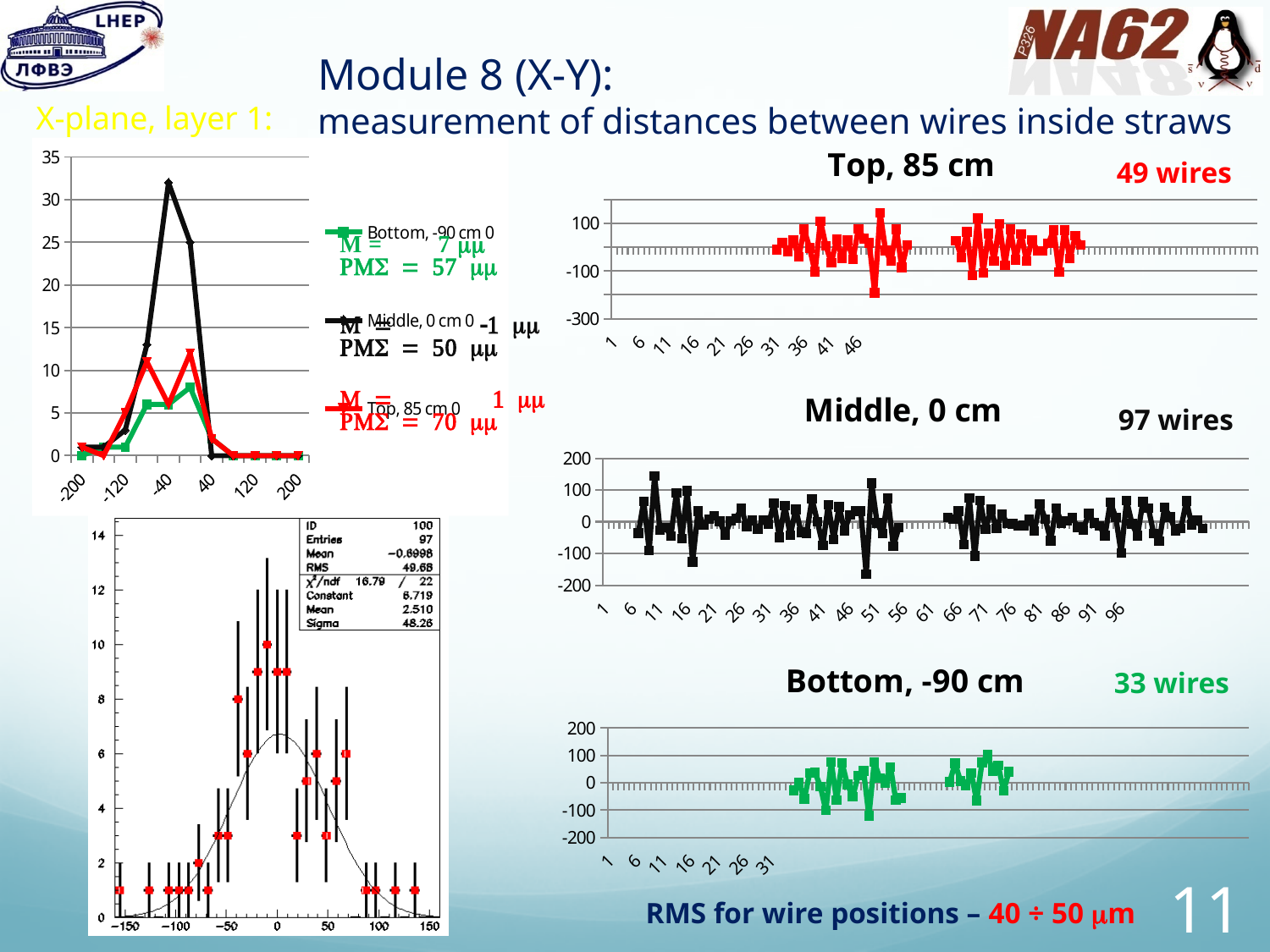
What is the lowest value shown on the y axis of the Top, 85 cm chart? -300 In the Top, 85 cm chart, is the lowest plotted point greater or less than -100? less In the Middle, 0 cm chart, is the highest plotted point greater or less than 100? greater How many wires are covered by the Middle, 0 cm chart? 97 wires In the top-left line chart, is the peak value of the Middle, 0 cm series greater or less than 30? greater In the bottom-left histogram, what RMS value is shown in the statistics box? 49.68 How many series does the legend of the top-left line chart list? 3 How many wires are covered by the Bottom, -90 cm chart? 33 wires In the top-left line chart, which series reaches the highest peak? Middle, 0 cm What kind of chart is the top-left chart with the green, black and red series? line chart In the bottom-left histogram, what is the number of Entries shown in the statistics box? 97 How many wires are covered by the Top, 85 cm chart? 49 wires